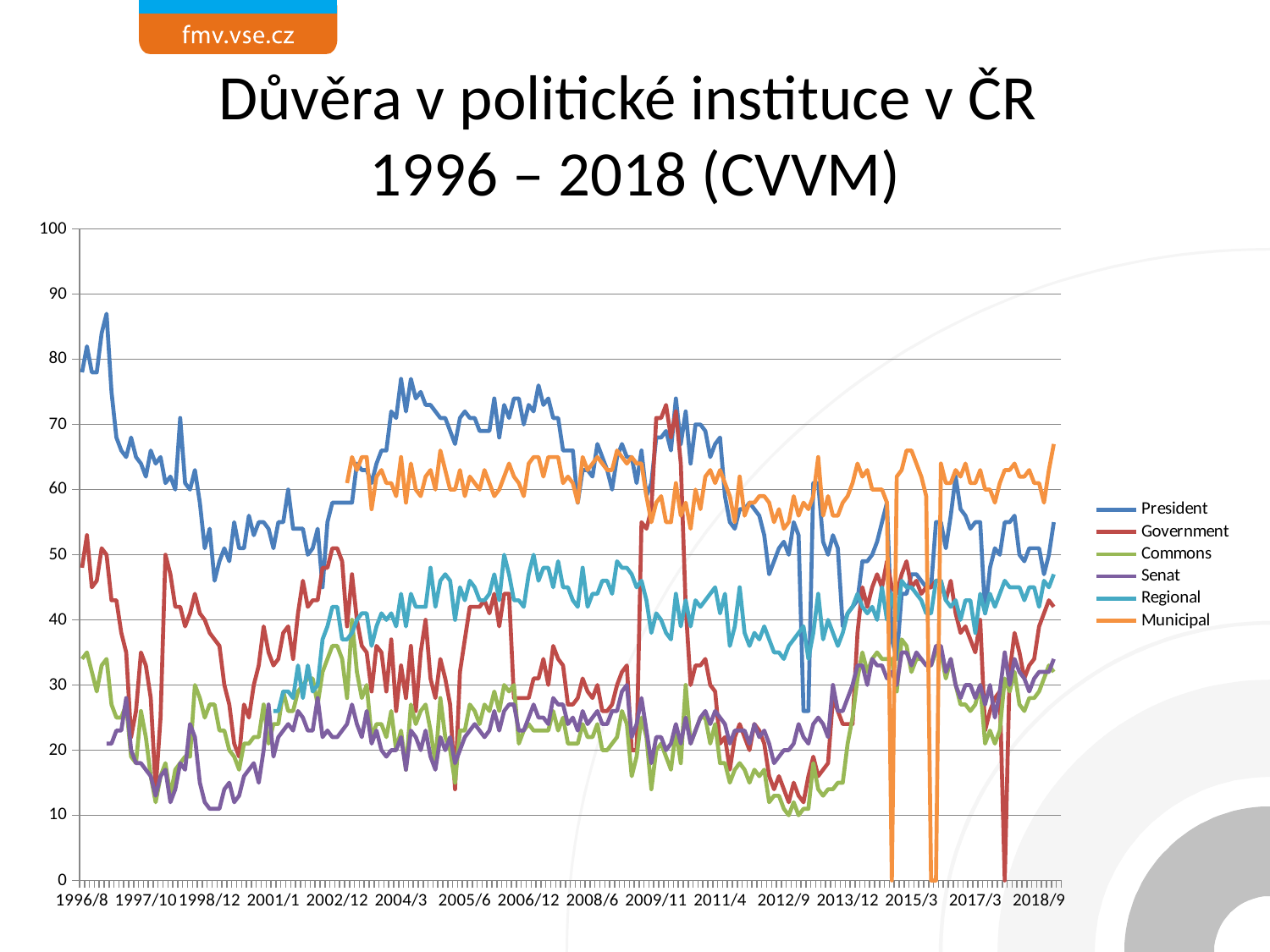
Which series reaches the highest value anywhere on the chart? President Is the value for Municipal around 2004/3 greater or less than 50? greater Is the value for Commons around 2012/9 greater or less than 20? less What is the title of the chart? Důvěra v politické instituce v ČR 1996 – 2018 (CVVM) How many series does the legend list? 6 What kind of chart is shown on the slide? line chart Is the value for Senat around 1998/12 greater or less than 20? less Which series has the highest value at the start of the chart (1996/8)? President At 2006/12, which is larger: Municipal or Senat? Municipal Which series is drawn in orange according to the legend? Municipal Does the President series rise or fall between 1996/8 and 1998/12? fall